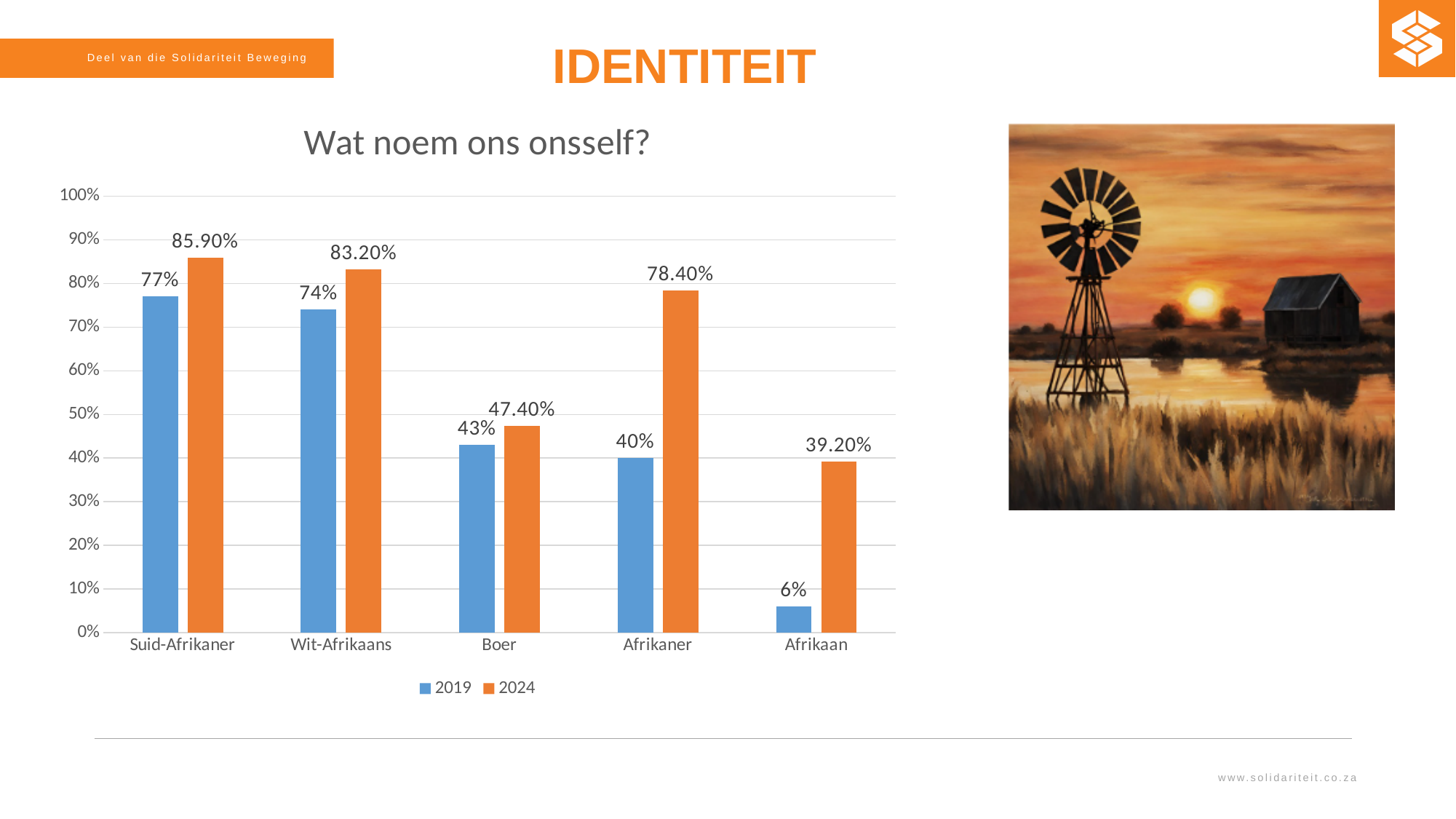
What is the title of the chart? Wat noem ons onsself? How many categories are shown on the x axis? 5 What is the 2019 value for Afrikaan? 6% What is the 2024 value for Suid-Afrikaner? 85.90% Which category has the lowest 2019 value? Afrikaan What is the 2019 value for Afrikaner? 40% What kind of chart is shown? Bar chart How many series does the legend list? 2 Which is larger: the 2019 value for Suid-Afrikaner or the 2019 value for Wit-Afrikaans? Suid-Afrikaner What is the difference between the 2024 and 2019 values for Afrikaner? 38.40% Which category has the highest 2024 value? Suid-Afrikaner What is the 2024 value for Boer? 47.40%